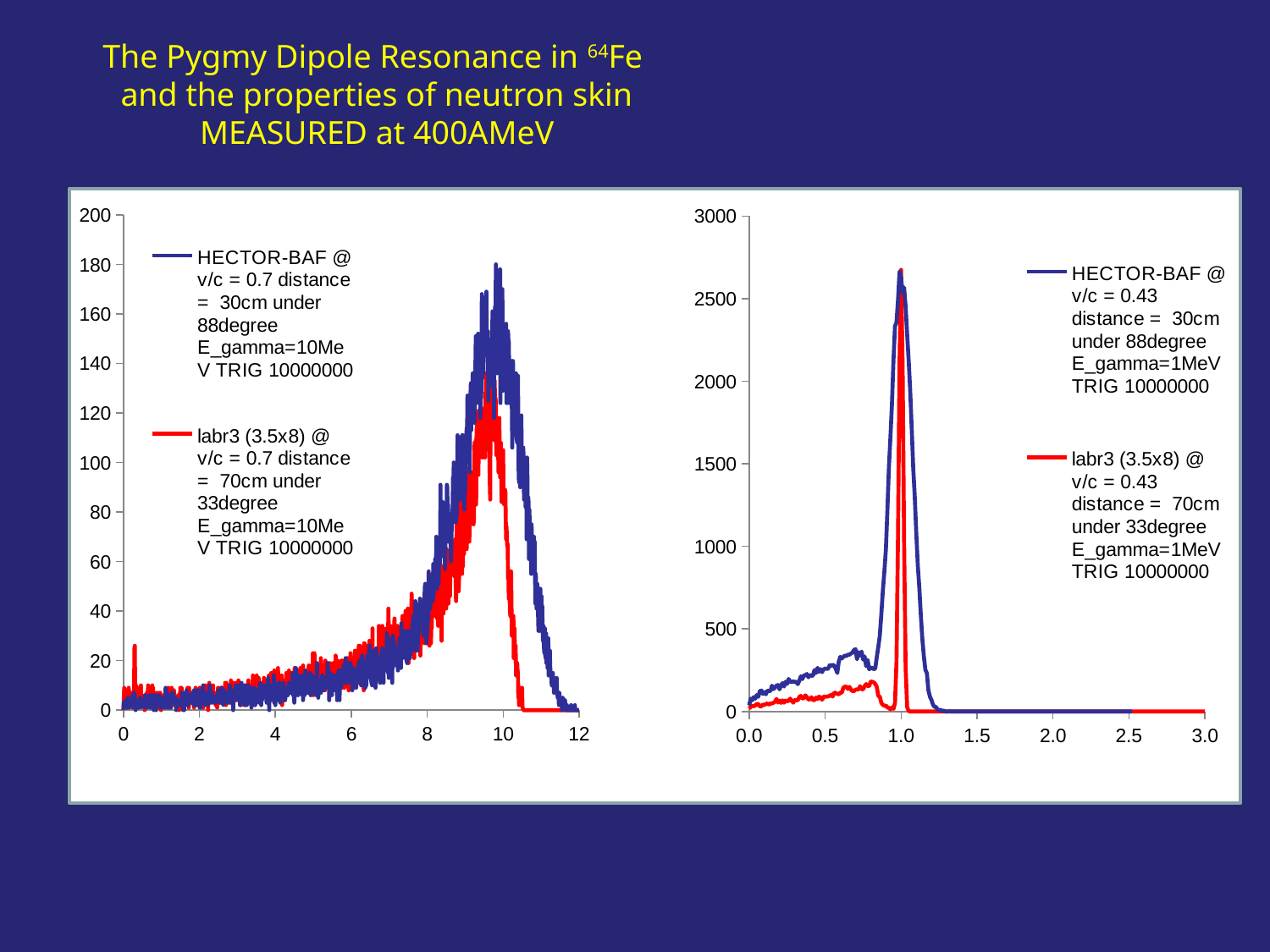
What is the highest value shown on the y axis of the right chart? 3000 In the right chart, which series extends further along the x axis before dropping to zero, HECTOR-BAF or labr3 (3.5x8)? HECTOR-BAF In the left chart, is the peak value of the HECTOR-BAF series greater or less than 160? greater What kind of chart is the chart on the left of the slide? line chart What colour is the HECTOR-BAF series drawn in on the left chart? blue How many series does the legend of the right chart list? 2 In the right chart, is the peak value of the HECTOR-BAF series greater or less than 2500? greater How many series does the legend of the left chart list? 2 In the left chart, which series reaches the higher peak, HECTOR-BAF or labr3 (3.5x8)? HECTOR-BAF In the right chart, is the value of the HECTOR-BAF series at x = 0.5 greater or less than 500? less What kind of chart is the chart on the right of the slide? line chart